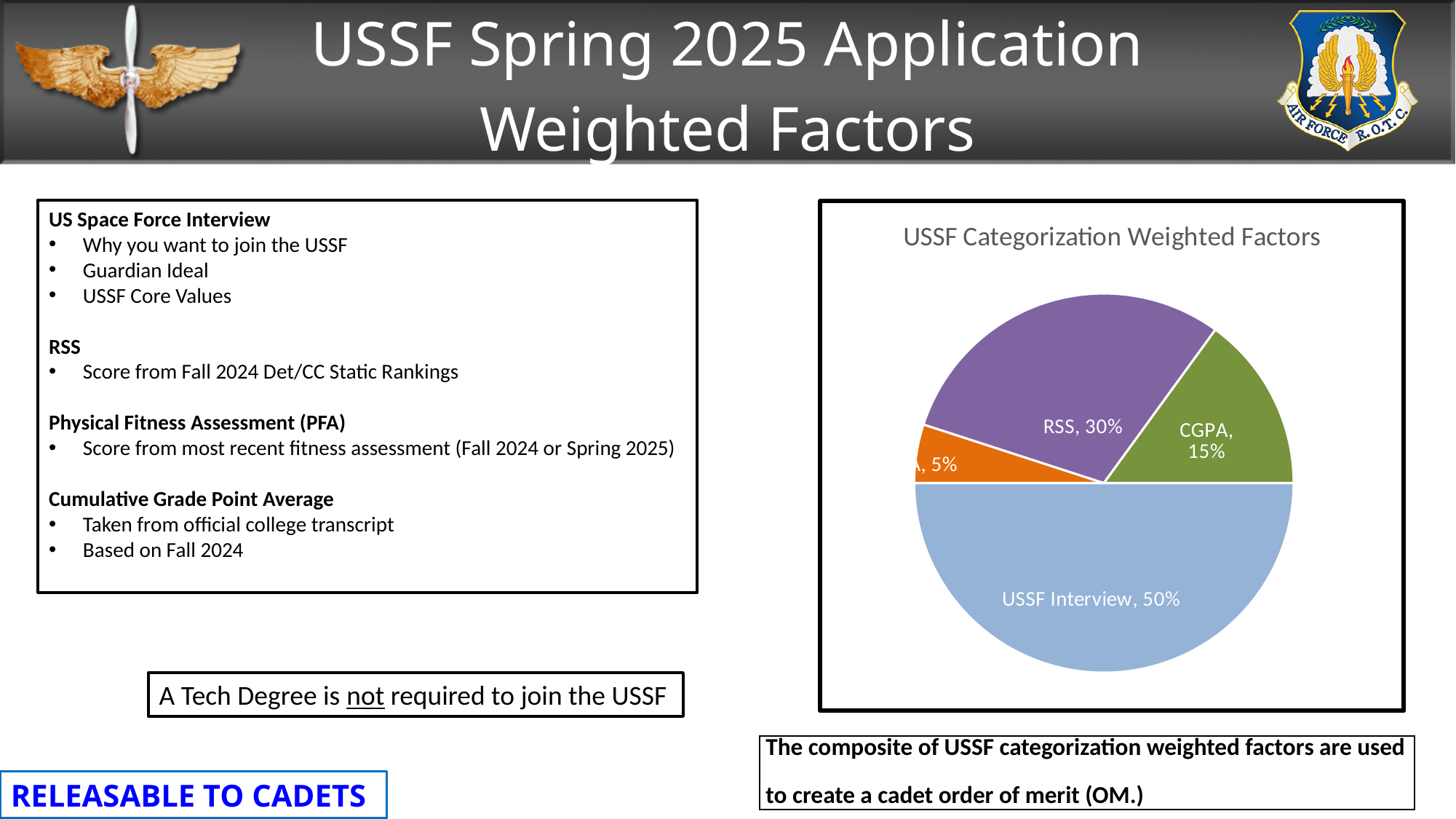
How many slices does the pie chart have? 4 What colour is the USSF Interview slice? light blue What is the percentage shown for the smallest slice of the pie? 5% What is the title of the chart? USSF Categorization Weighted Factors What percentage does the USSF Interview slice represent? 50% Which category has the largest share of the pie? USSF Interview What percentage does the RSS slice represent? 30% What is the difference between the RSS share and the CGPA share? 15% Which is larger, the RSS share or the CGPA share? RSS What percentage does the CGPA slice represent? 15% What is the difference between the USSF Interview share and the RSS share? 20% What kind of chart is shown on the slide? pie chart